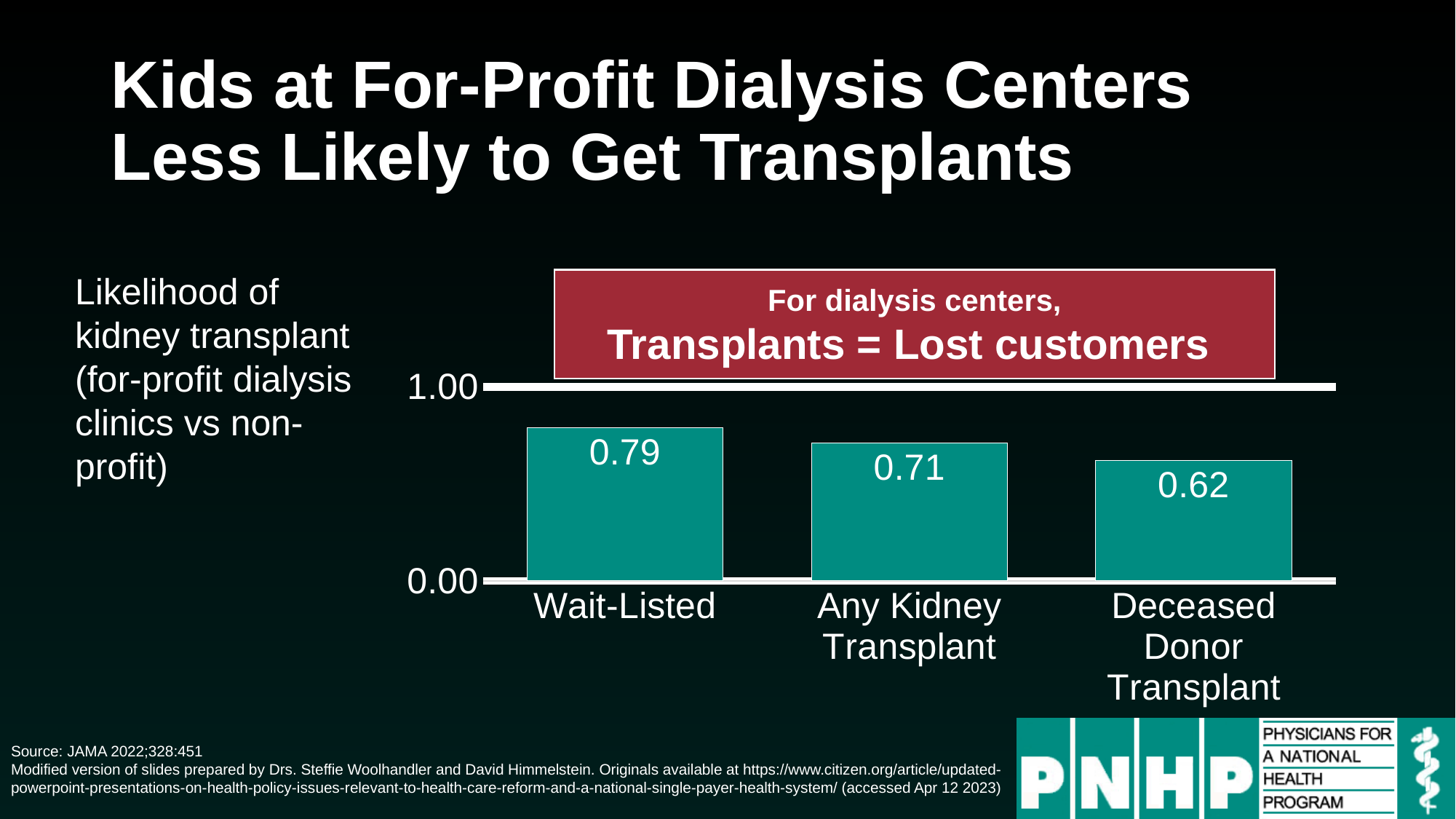
What is the difference between the values for Any Kidney Transplant and Deceased Donor Transplant? 0.09 What is the difference between the values for Wait-Listed and Deceased Donor Transplant? 0.17 Which category has the highest value? Wait-Listed Is the value for Deceased Donor Transplant greater or less than 1.00? less Which category has the lowest value? Deceased Donor Transplant Do the values rise or fall from left to right across the categories? fall What kind of chart is shown on the slide? bar chart How many categories are shown in the chart? 3 What is the value for Deceased Donor Transplant? 0.62 What is the value for Any Kidney Transplant? 0.71 Which is larger, the value for Wait-Listed or the value for Any Kidney Transplant? Wait-Listed What is the value for Wait-Listed? 0.79